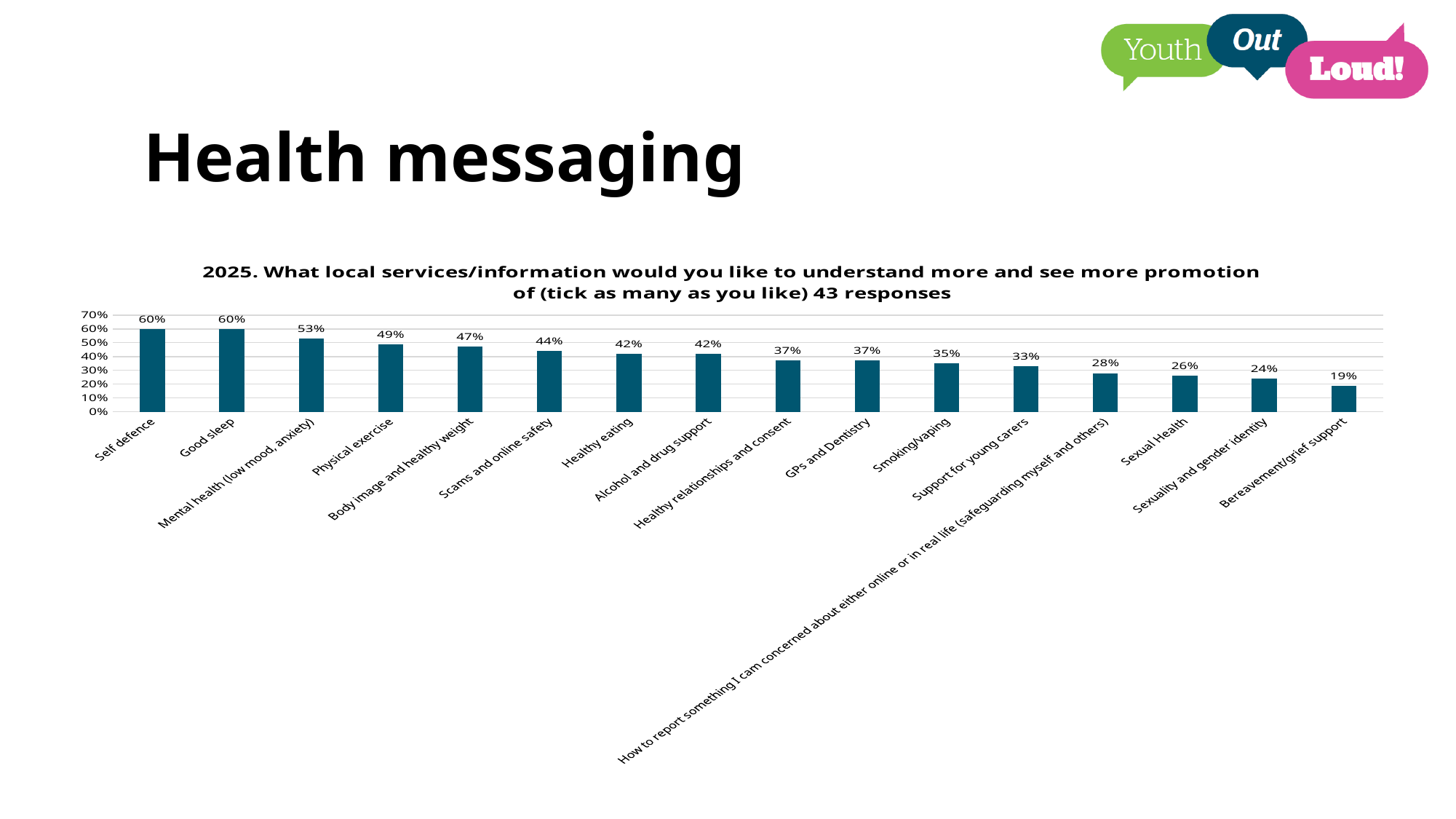
What is the value for Scams and online safety? 44% Which category has the lowest value? Bereavement/grief support Do the values rise or fall from left to right along the x axis? Fall Is the value for Sexuality and gender identity greater or less than 30%? less What is the difference between Self defence and Bereavement/grief support? 41% Which is larger, the value for Body image and healthy weight or the value for GPs and Dentistry? Body image and healthy weight How many categories are shown on the chart? 16 What percentage is shown for Sexual Health? 26% What is the difference between the values for Physical exercise and Support for young carers? 16% What type of chart is shown on the slide? Bar chart What percentage of respondents selected Mental health (low mood, anxiety)? 53% What is the value shown for Smoking/vaping? 35%